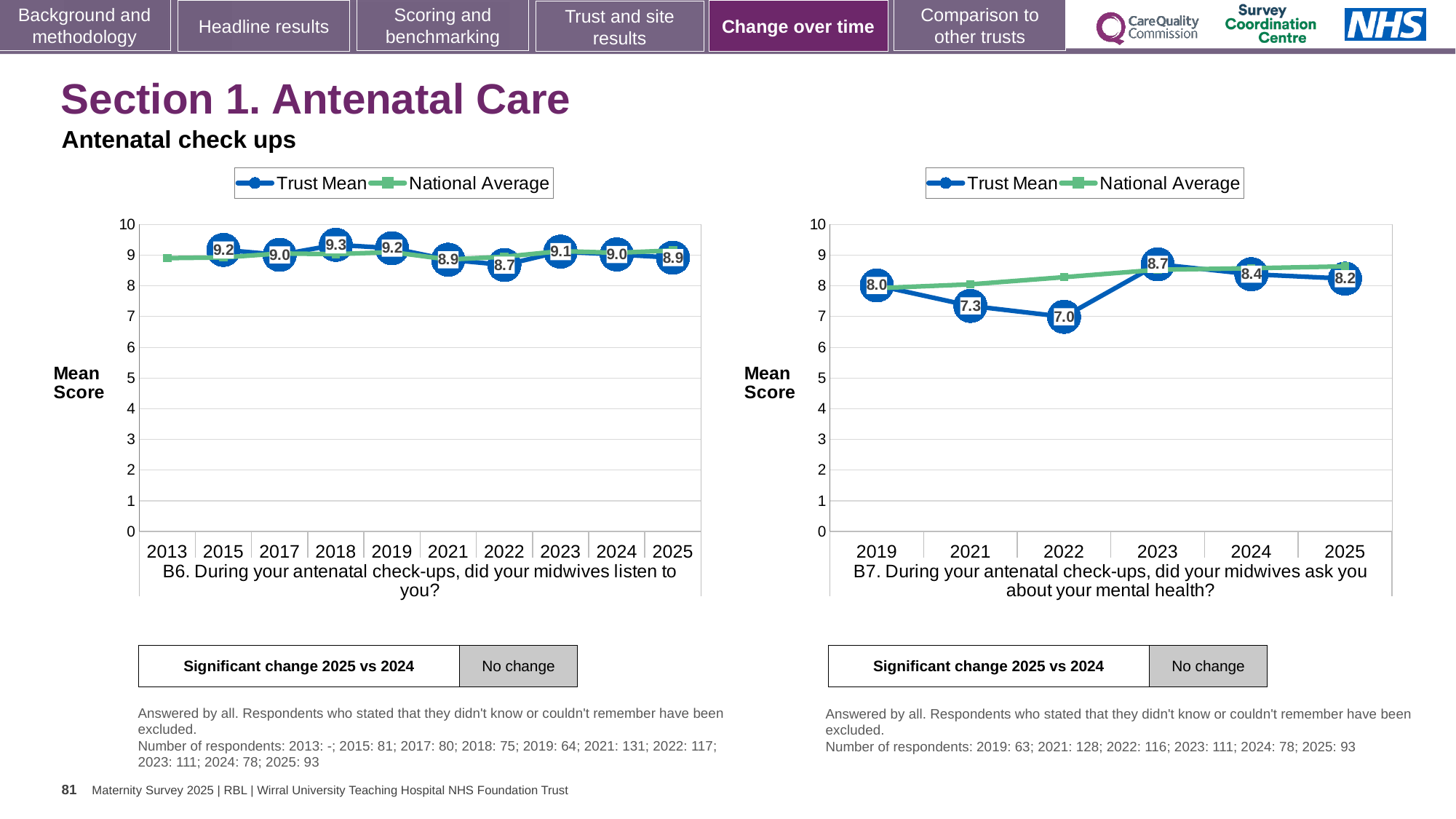
In the B6 chart (left), what is the Trust Mean for 2022? 8.7 In the B7 chart (right), what is the difference between the Trust Mean for 2023 and the Trust Mean for 2022? 1.7 In the B6 chart (left), what is the Trust Mean for 2018? 9.3 How many years are shown on the x axis of the B7 chart (right)? 6 In the B7 chart (right), which year has the lowest Trust Mean? 2022 In the B6 chart (left), which year has the lowest Trust Mean? 2022 In the B7 chart (right), is the Trust Mean for 2021 greater or less than 8? less In the B6 chart (left), is the Trust Mean for 2018 or for 2021 larger? 2018 In the B7 chart (right), what is the Trust Mean for 2022? 7.0 In the B7 chart (right), what is the Trust Mean for 2025? 8.2 In the B7 chart (right), which year has the highest Trust Mean? 2023 How many series does the legend of the B6 chart (left) list? 2